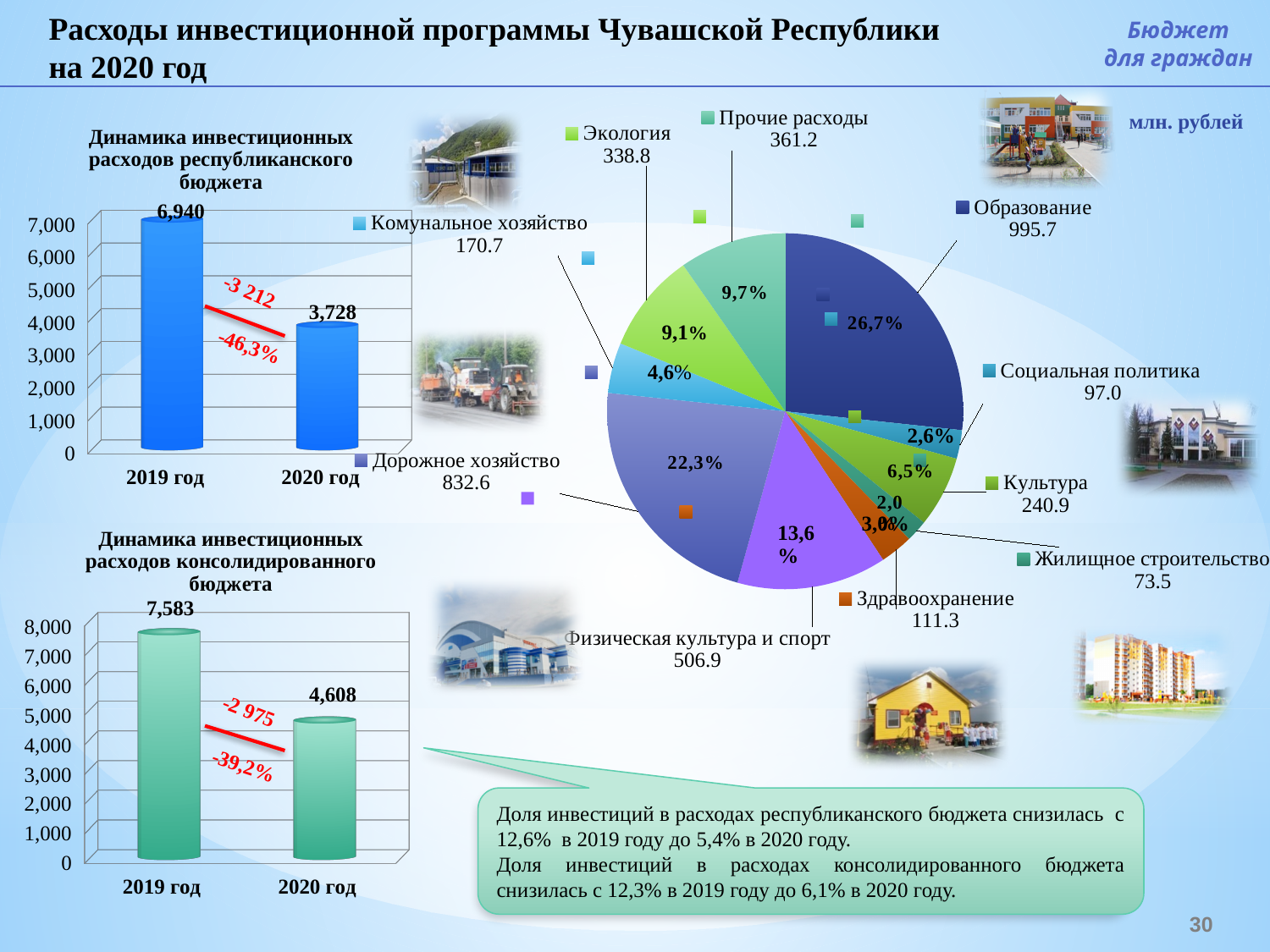
In the chart 'Динамика инвестиционных расходов консолидированного бюджета', what is the value for 2019 год? 7,583 In the chart 'Динамика инвестиционных расходов республиканского бюджета', what is the difference between the 2019 год and 2020 год values? 3,212 In the pie chart on the right, what is the value for Образование? 995.7 In the chart 'Динамика инвестиционных расходов консолидированного бюджета', what is the value for 2020 год? 4,608 In the chart 'Динамика инвестиционных расходов консолидированного бюджета', do the values rise or fall from 2019 год to 2020 год? fall How many categories does the pie chart on the right show? 10 In the chart 'Динамика инвестиционных расходов консолидированного бюджета', what percentage change is shown between 2019 год and 2020 год? -39,2% In the chart 'Динамика инвестиционных расходов республиканского бюджета', what is the value for 2020 год? 3,728 In the chart 'Динамика инвестиционных расходов республиканского бюджета', what is the value for 2019 год? 6,940 In the pie chart on the right, which category has the smallest value? Жилищное строительство In the pie chart on the right, what share does Дорожное хозяйство have? 22,3% What kind of chart is 'Динамика инвестиционных расходов республиканского бюджета'? bar chart